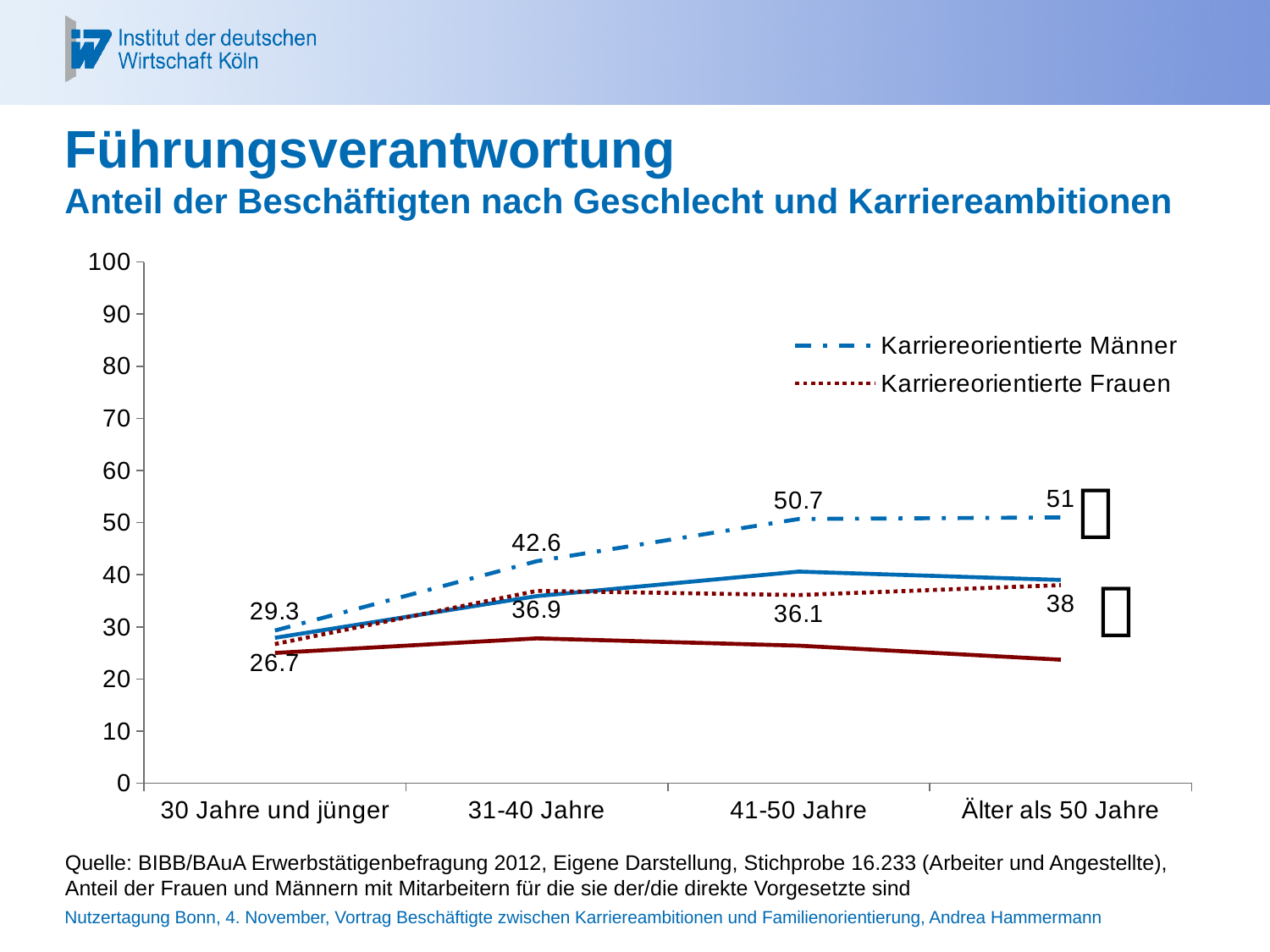
What is the difference between Karriereorientierte Männer and Karriereorientierte Frauen in the 41-50 Jahre category? 14.6 Is the value for Karriereorientierte Männer in the Älter als 50 Jahre category greater or less than 40? greater What is the value for Karriereorientierte Männer in the 41-50 Jahre category? 50.7 What is the value for Karriereorientierte Frauen in the 30 Jahre und jünger category? 26.7 What is the value for Karriereorientierte Frauen in the Älter als 50 Jahre category? 38 In which age category is the value for Karriereorientierte Männer highest? Älter als 50 Jahre How many series does the legend list? 2 How many age categories are shown on the x axis? 4 In which age category is the value for Karriereorientierte Frauen lowest? 30 Jahre und jünger What kind of chart is shown on the slide? line chart What is the value for Karriereorientierte Männer in the 31-40 Jahre category? 42.6 Which is larger in the 31-40 Jahre category: Karriereorientierte Männer or Karriereorientierte Frauen? Karriereorientierte Männer